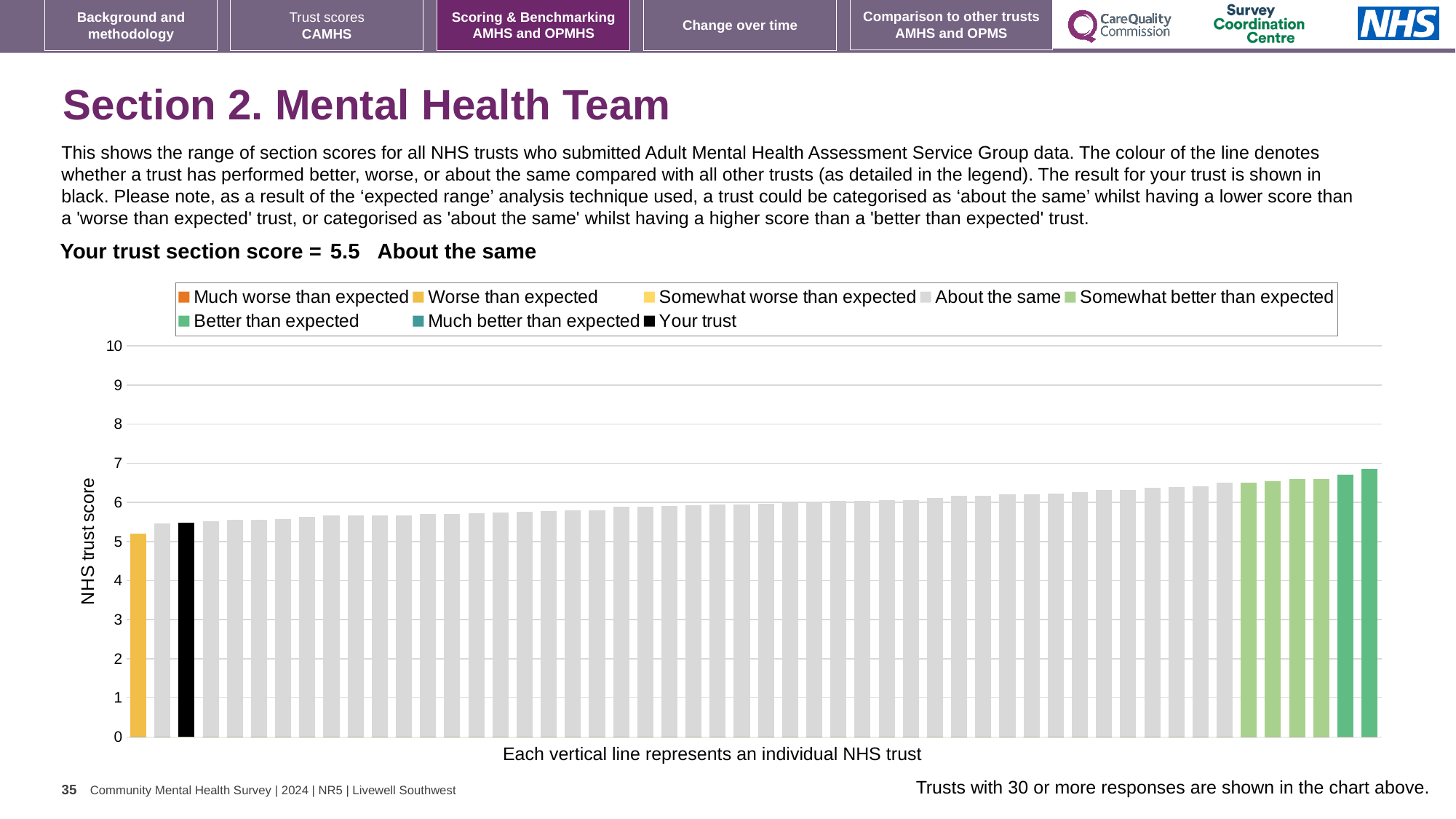
How many entries does the chart legend list? 8 What is the label on the vertical axis of the chart? NHS trust score Do the bar values rise or fall from left to right across the chart? rise What kind of chart is shown on the slide? bar chart Which is higher, the 'Your trust' bar or the rightmost bar in the chart? the rightmost bar Is the value of the leftmost bar in the chart greater or less than 6? less What colour is the bar representing your trust in the chart? black What is the section score for your trust shown on the slide? 5.5 Is the value of the 'Your trust' bar greater or less than 5? greater Is the value of the tallest bar in the chart greater or less than 7? less Which is higher, the 'Your trust' bar or the leftmost bar in the chart? the 'Your trust' bar